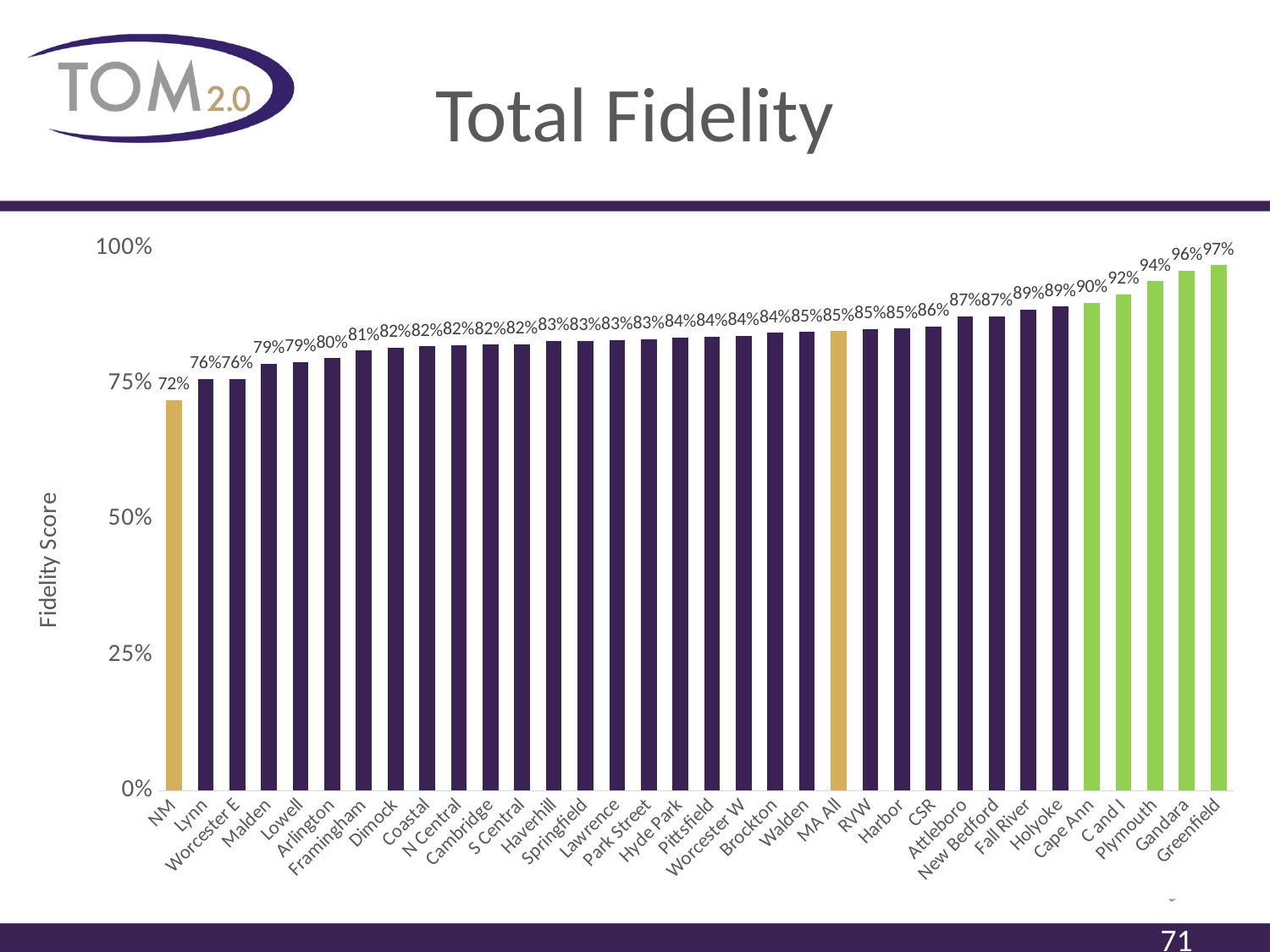
What is the fidelity score for Greenfield? 97% What is the label on the vertical axis of the chart? Fidelity Score What is the difference between the fidelity scores of Greenfield and NM? 25 percentage points How many sites are shown on the x axis of the chart? 34 Which has a higher fidelity score, Plymouth or Lynn? Plymouth What is the fidelity score for NM? 72% Which site has the lowest fidelity score? NM What is the fidelity score for MA All? 85% Which site has the highest fidelity score? Greenfield What is the fidelity score for Cape Ann? 90% Do the fidelity scores rise or fall from left to right along the x axis? Rise What kind of chart is shown on the slide? Bar chart